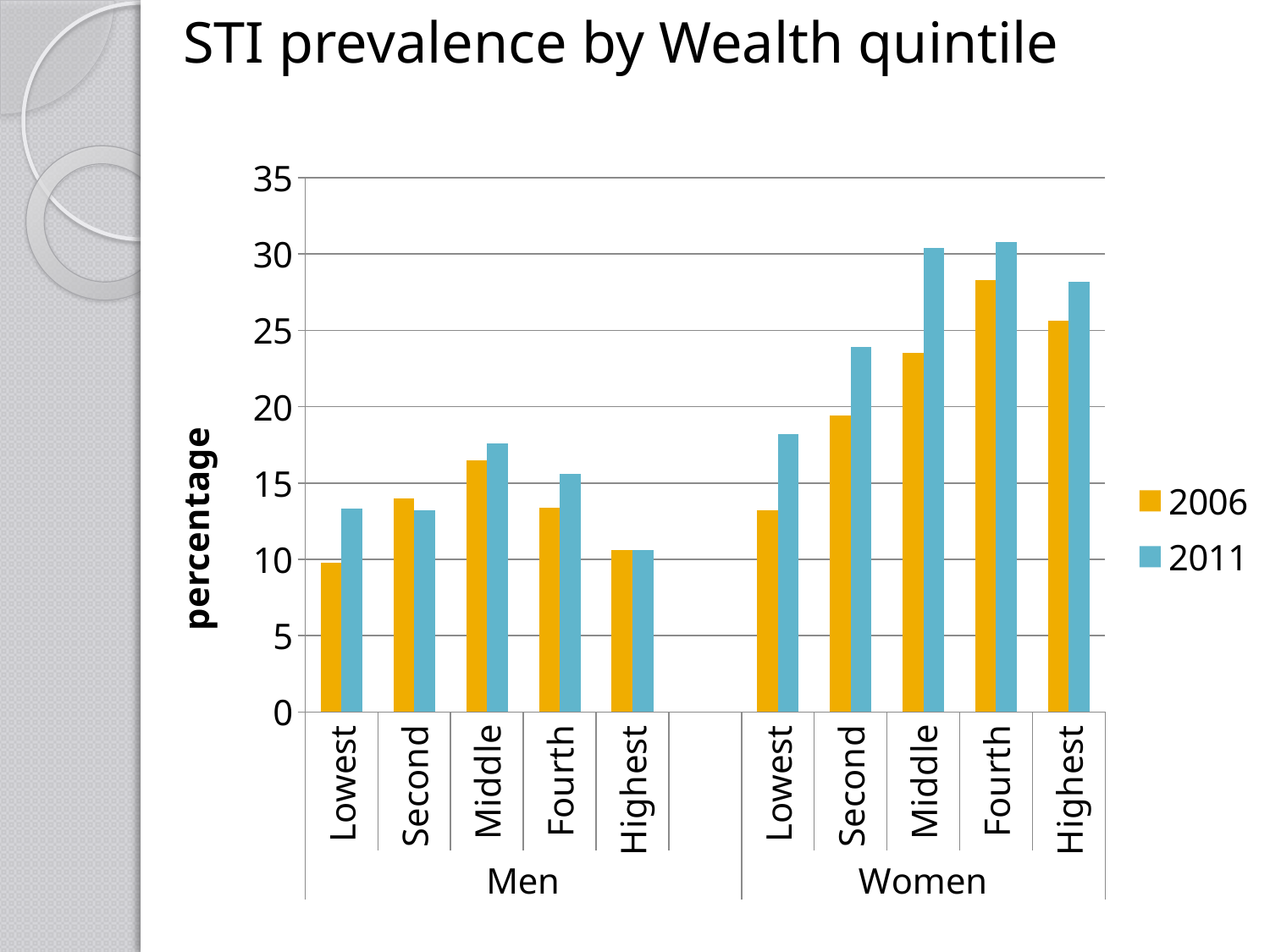
Is the 2011 value for Women in the Lowest quintile greater or less than 20? less What is the label on the vertical axis? percentage What are the two series named in the legend? 2006 and 2011 Which category has the highest 2006 value? Women, Fourth For Men in the Second quintile, which year has the larger value, 2006 or 2011? 2006 How many wealth quintile categories are plotted in total across the Men and Women groups? 10 Is the 2006 value for Men in the Middle quintile greater or less than 15? greater Which category has the lowest 2011 value? Men, Highest What kind of chart is shown on the slide? bar chart Is the 2006 value for Women in the Fourth quintile greater or less than 25? greater How many series does the legend list? 2 For Women in the Lowest quintile, which year has the larger value, 2006 or 2011? 2011